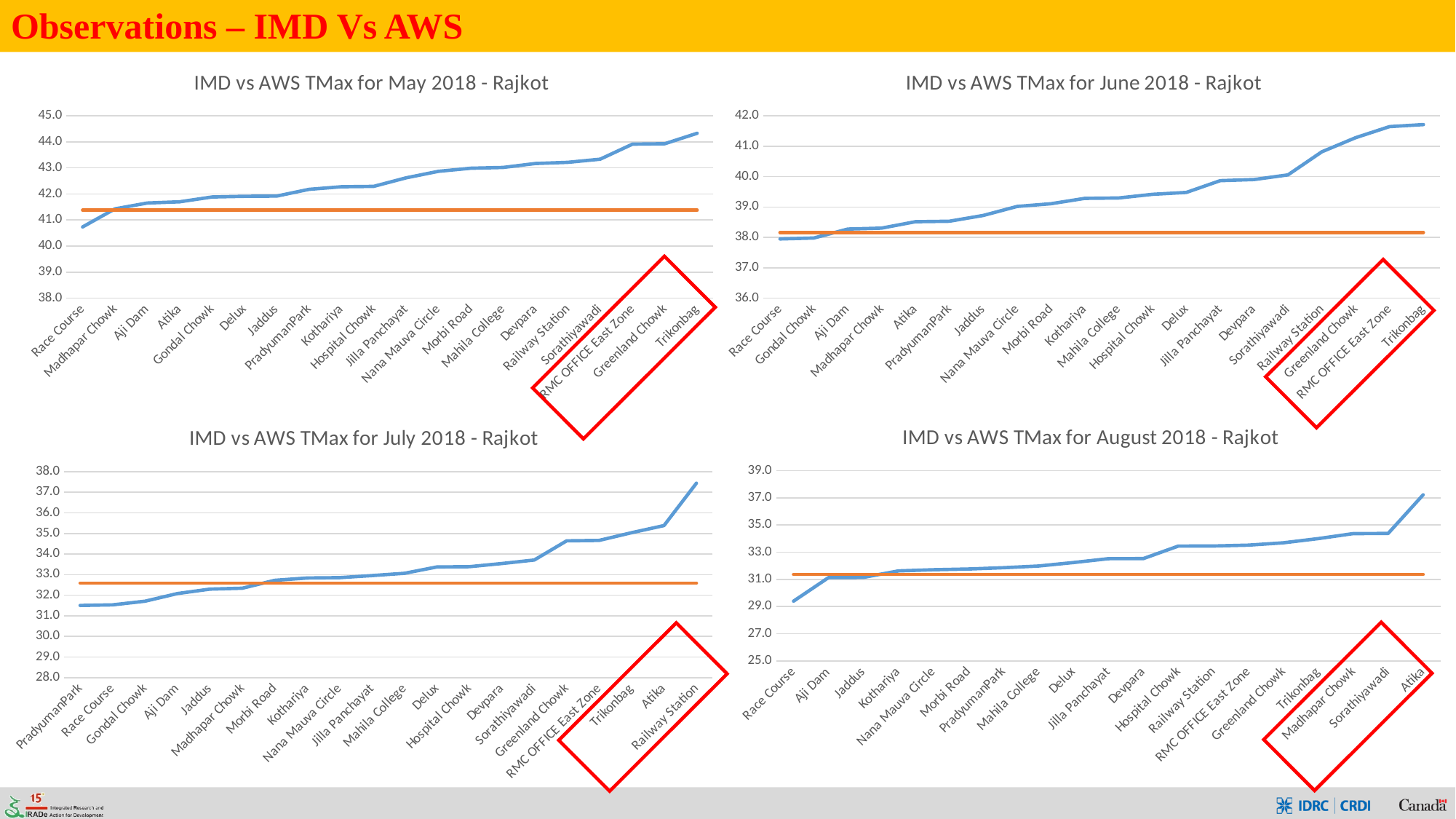
In the 'IMD vs AWS TMax for August 2018 - Rajkot' chart, does the blue line generally rise or fall from left to right? rise In the 'IMD vs AWS TMax for May 2018 - Rajkot' chart, how many stations are plotted along the x axis? 20 In the 'IMD vs AWS TMax for July 2018 - Rajkot' chart, is the blue line value for PradyumanPark greater or less than 32.0? less In the 'IMD vs AWS TMax for August 2018 - Rajkot' chart, which station has the lowest value on the blue line? Race Course In the 'IMD vs AWS TMax for May 2018 - Rajkot' chart, is the blue line value for Race Course greater or less than 41.0? less In the 'IMD vs AWS TMax for July 2018 - Rajkot' chart, which station has the highest value on the blue line? Railway Station How many charts are shown on the slide? 4 In the 'IMD vs AWS TMax for May 2018 - Rajkot' chart, which station has the highest value on the blue line? Trikonbag In the 'IMD vs AWS TMax for August 2018 - Rajkot' chart, how many stations are plotted along the x axis? 19 In the 'IMD vs AWS TMax for June 2018 - Rajkot' chart, which station has the highest value on the blue line? Trikonbag In the 'IMD vs AWS TMax for June 2018 - Rajkot' chart, is the blue line value for Trikonbag greater or less than 41.0? greater What kind of chart is the 'IMD vs AWS TMax for May 2018 - Rajkot' chart? line chart